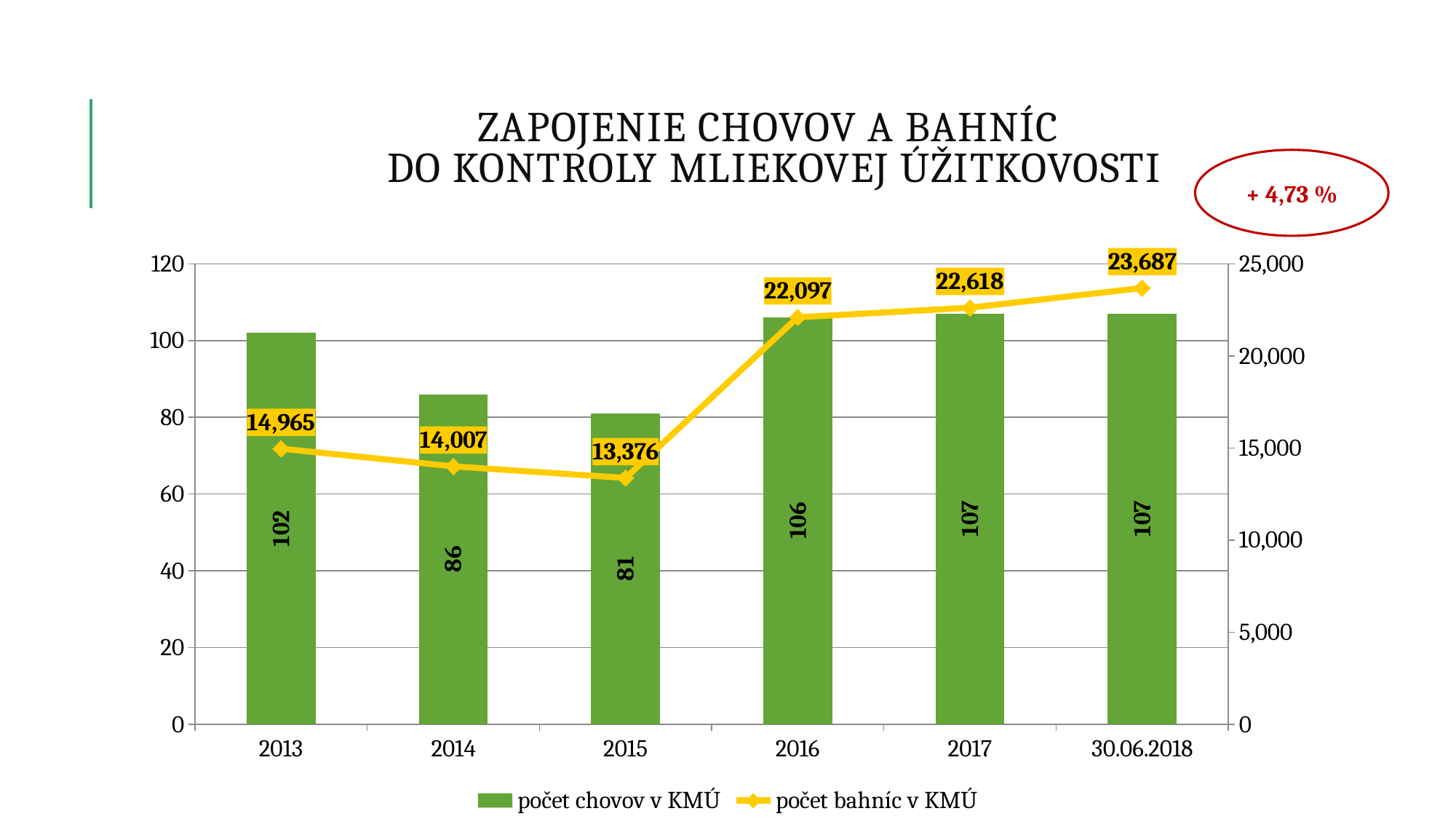
What is the value of 'počet bahníc v KMÚ' for 30.06.2018? 23,687 Does 'počet bahníc v KMÚ' rise or fall from 2015 to 30.06.2018? rise Which is larger, 'počet chovov v KMÚ' in 2014 or in 2016? 2016 What is the difference in 'počet bahníc v KMÚ' between 2016 and 2015? 8,721 How many series does the legend list? 2 Which year has the lowest value for 'počet chovov v KMÚ'? 2015 What is the difference in 'počet chovov v KMÚ' between 2013 and 2014? 16 Which category has the highest value for 'počet bahníc v KMÚ'? 30.06.2018 What percentage is shown in the red oval next to the chart title? + 4,73 % What is the value of 'počet bahníc v KMÚ' for 2015? 13,376 What is the value of 'počet chovov v KMÚ' for 2013? 102 How many categories are shown on the x axis? 6